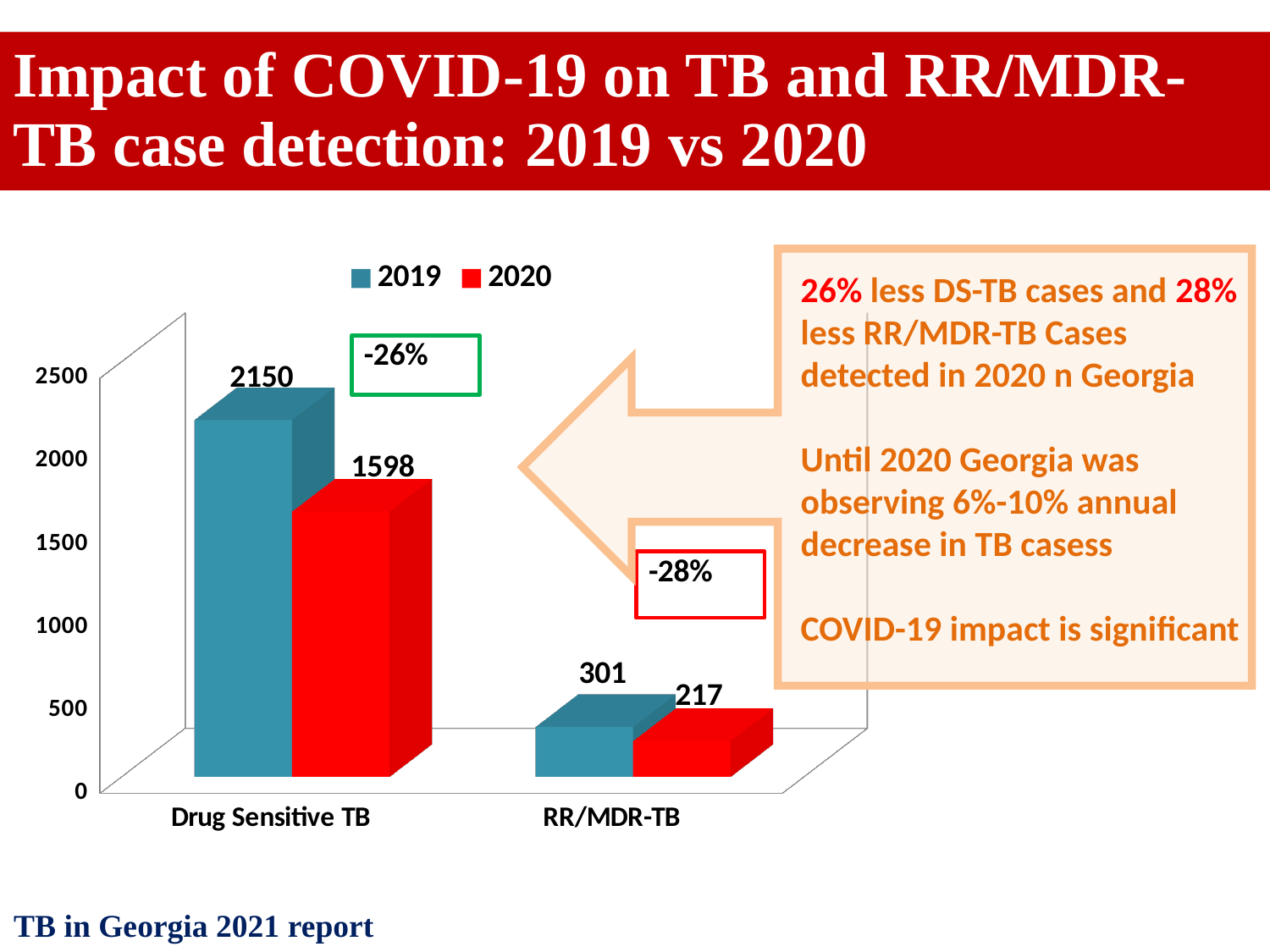
What is the value for Drug Sensitive TB in 2020? 1598 Which category has the lowest value in the 2020 series? RR/MDR-TB Which is larger: the 2019 value for RR/MDR-TB or the 2020 value for RR/MDR-TB? 2019 What is the value for RR/MDR-TB in 2020? 217 What is the difference between the 2019 and 2020 values for RR/MDR-TB? 84 What is the difference between the 2019 and 2020 values for Drug Sensitive TB? 552 What is the value for Drug Sensitive TB in 2019? 2150 What kind of chart is shown on the slide? bar chart What is the value for RR/MDR-TB in 2019? 301 How many categories are shown on the x axis? 2 Which category has the highest value in the 2019 series? Drug Sensitive TB How many series does the legend list? 2